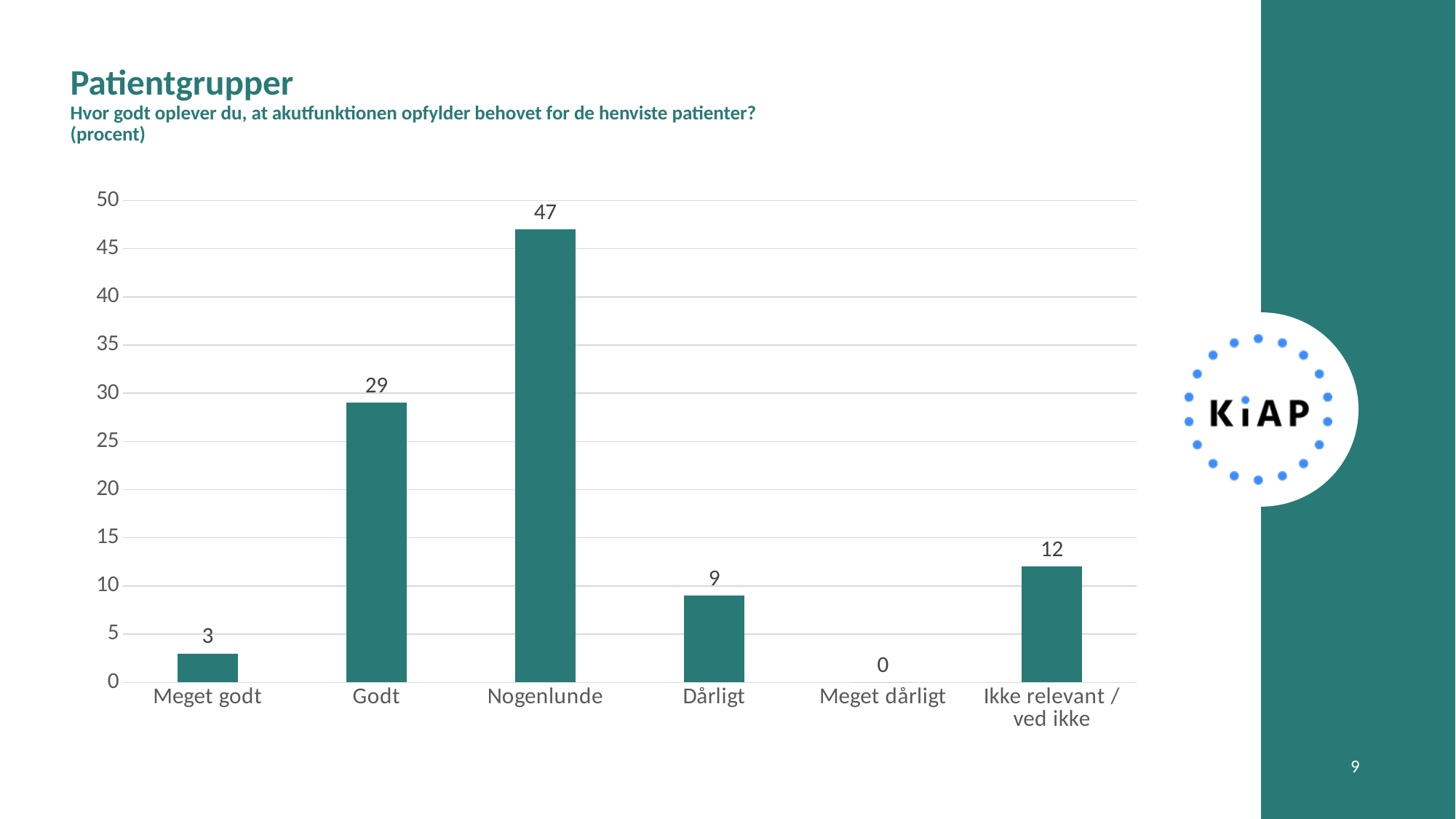
How many categories are shown on the x axis? 6 What is the value for Meget dårligt? 0 What is the title of the slide? Patientgrupper What is the difference between the values for Nogenlunde and Godt? 18 Which is larger, the value for Dårligt or the value for Ikke relevant / ved ikke? Ikke relevant / ved ikke What is the value for Nogenlunde? 47 What is the value for Ikke relevant / ved ikke? 12 Which category has the highest value? Nogenlunde Is the value for Godt greater or less than 25? greater Which category has the lowest value? Meget dårligt What kind of chart is shown on the slide? Bar chart What is the value for Godt? 29